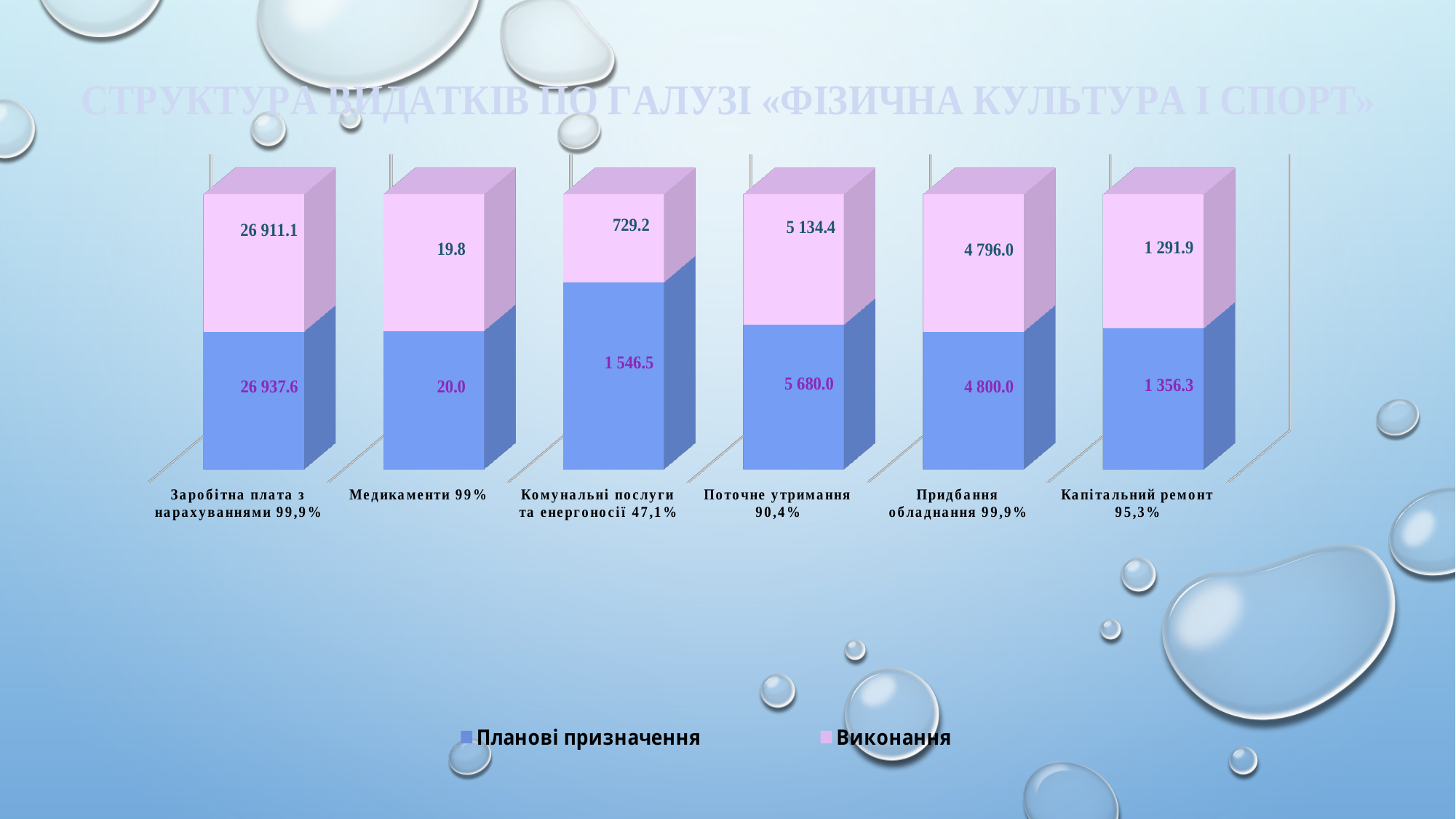
What is the difference between Планові призначення and Виконання for Капітальний ремонт? 64.4 Which category has the highest value of Планові призначення? Заробітна плата з нарахуваннями What is the value of Планові призначення for Заробітна плата з нарахуваннями? 26 937.6 How many categories are shown on the x axis? 6 What kind of chart is shown on the slide? Stacked bar chart Which category has the lowest value of Виконання? Медикаменти What is the difference between Планові призначення and Виконання for Поточне утримання? 545.6 What is the value of Планові призначення for Капітальний ремонт? 1 356.3 What is the value of Виконання for Комунальні послуги та енергоносії? 729.2 How many series does the legend list? 2 What is the value of Виконання for Поточне утримання? 5 134.4 For Комунальні послуги та енергоносії, which is larger: Планові призначення or Виконання? Планові призначення